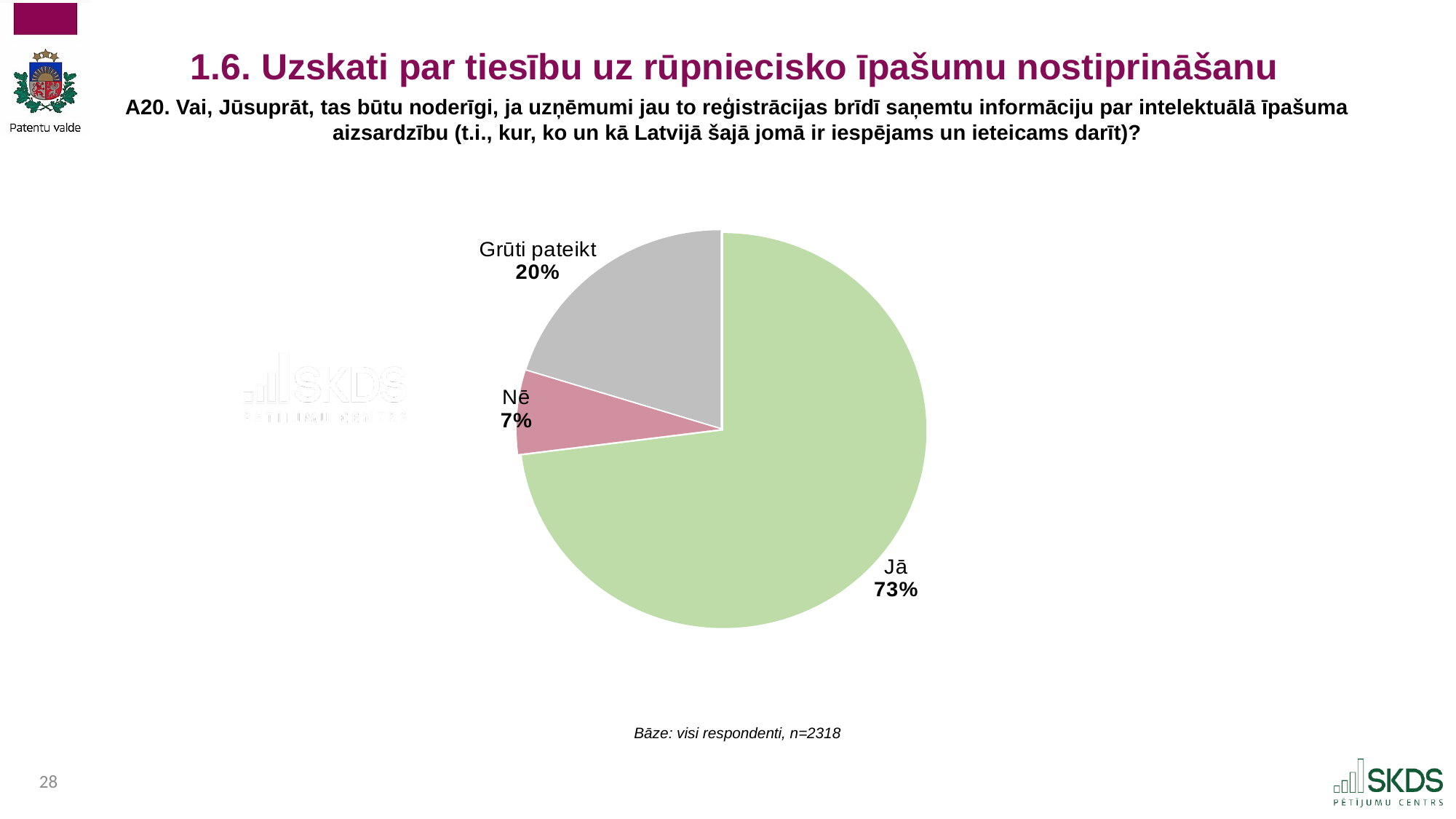
Which response has the smallest share of the pie? Nē What colour is the "Jā" slice of the pie chart? Green What is the base (n) of respondents stated below the chart? n=2318 Which is larger, the share for "Nē" or the share for "Grūti pateikt"? Grūti pateikt Which response has the largest share of the pie? Jā What kind of chart is shown on the slide? Pie chart What percentage of respondents answered "Nē"? 7% What percentage of respondents answered "Grūti pateikt"? 20% What is the difference in percentage points between "Jā" and "Grūti pateikt"? 53 What percentage of respondents answered "Jā"? 73% How many slices does the pie chart have? 3 What is the difference in percentage points between "Grūti pateikt" and "Nē"? 13